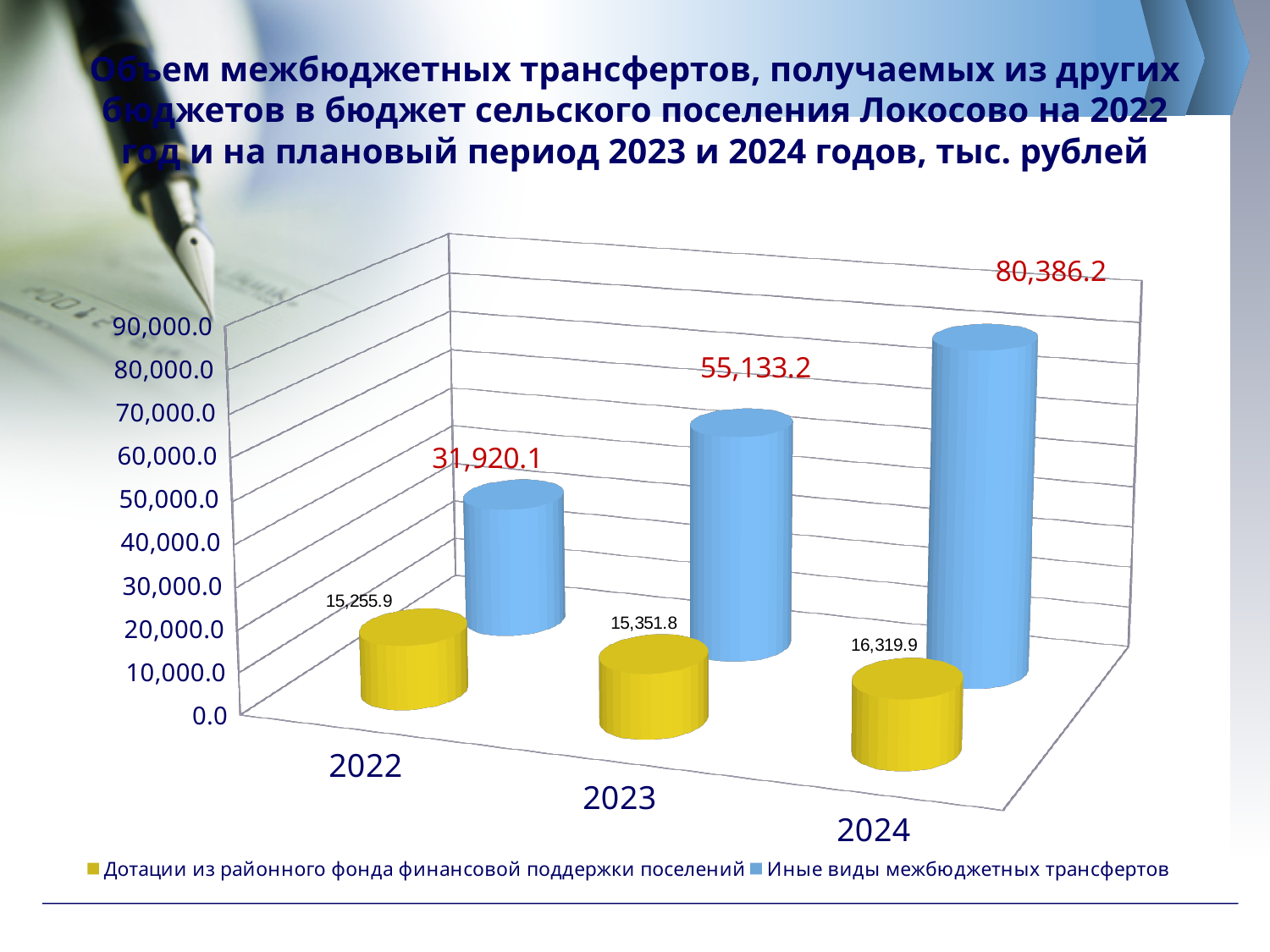
In which year is the value for Дотации из районного фонда финансовой поддержки поселений the lowest? 2022 How many years are shown on the x axis? 3 What is the value for Дотации из районного фонда финансовой поддержки поселений in 2024? 16,319.9 What is the value for Иные виды межбюджетных трансфертов in 2023? 55,133.2 Which is larger in 2023: Дотации из районного фонда финансовой поддержки поселений or Иные виды межбюджетных трансфертов? Иные виды межбюджетных трансфертов In which year is the value for Иные виды межбюджетных трансфертов the highest? 2024 What is the value for Иные виды межбюджетных трансфертов in 2024? 80,386.2 What is the difference between the Иные виды межбюджетных трансфертов values for 2023 and 2022? 23,213.1 How many series does the legend list? 2 Do the values for Иные виды межбюджетных трансфертов rise or fall from 2022 to 2024? rise What is the value for Дотации из районного фонда финансовой поддержки поселений in 2022? 15,255.9 What is the difference between the Иные виды межбюджетных трансфертов values for 2024 and 2022? 48,466.1